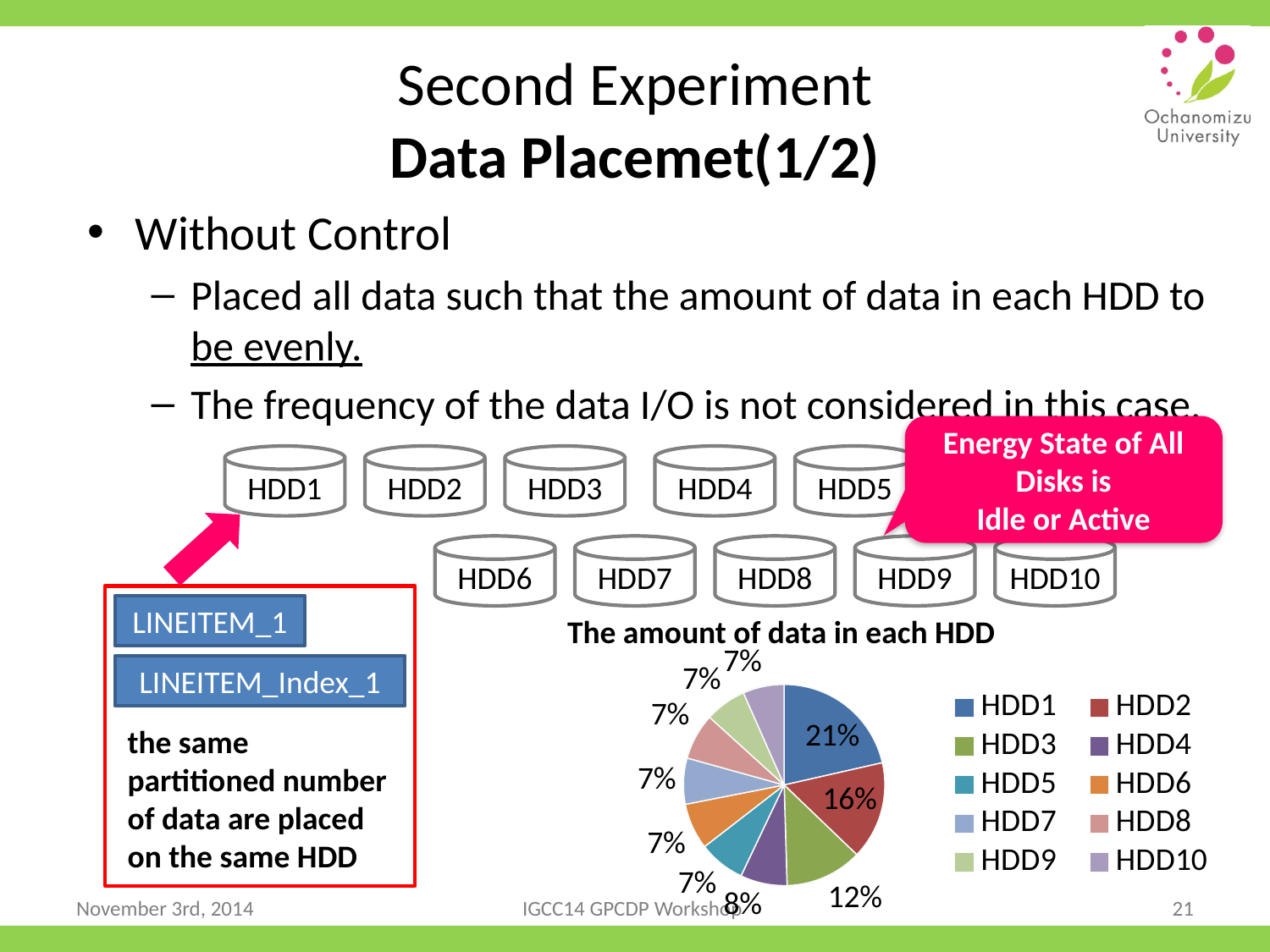
What is the title of the pie chart? The amount of data in each HDD What percentage is shown for HDD3 in the pie chart? 12% How many entries does the legend of the pie chart list? 10 What kind of chart is shown on the slide? pie chart What percentage is shown for HDD4 in the pie chart? 8% What share of the data is on HDD1 according to the pie chart? 21% What percentage is shown for HDD2 in the pie chart? 16% What is the difference between the percentages for HDD1 and HDD2 in the pie chart? 5% What percentage is shown for HDD7 in the pie chart? 7% Which HDD has the largest slice in the pie chart? HDD1 How many slices does the pie chart have? 10 Which has a larger share in the pie chart, HDD2 or HDD3? HDD2